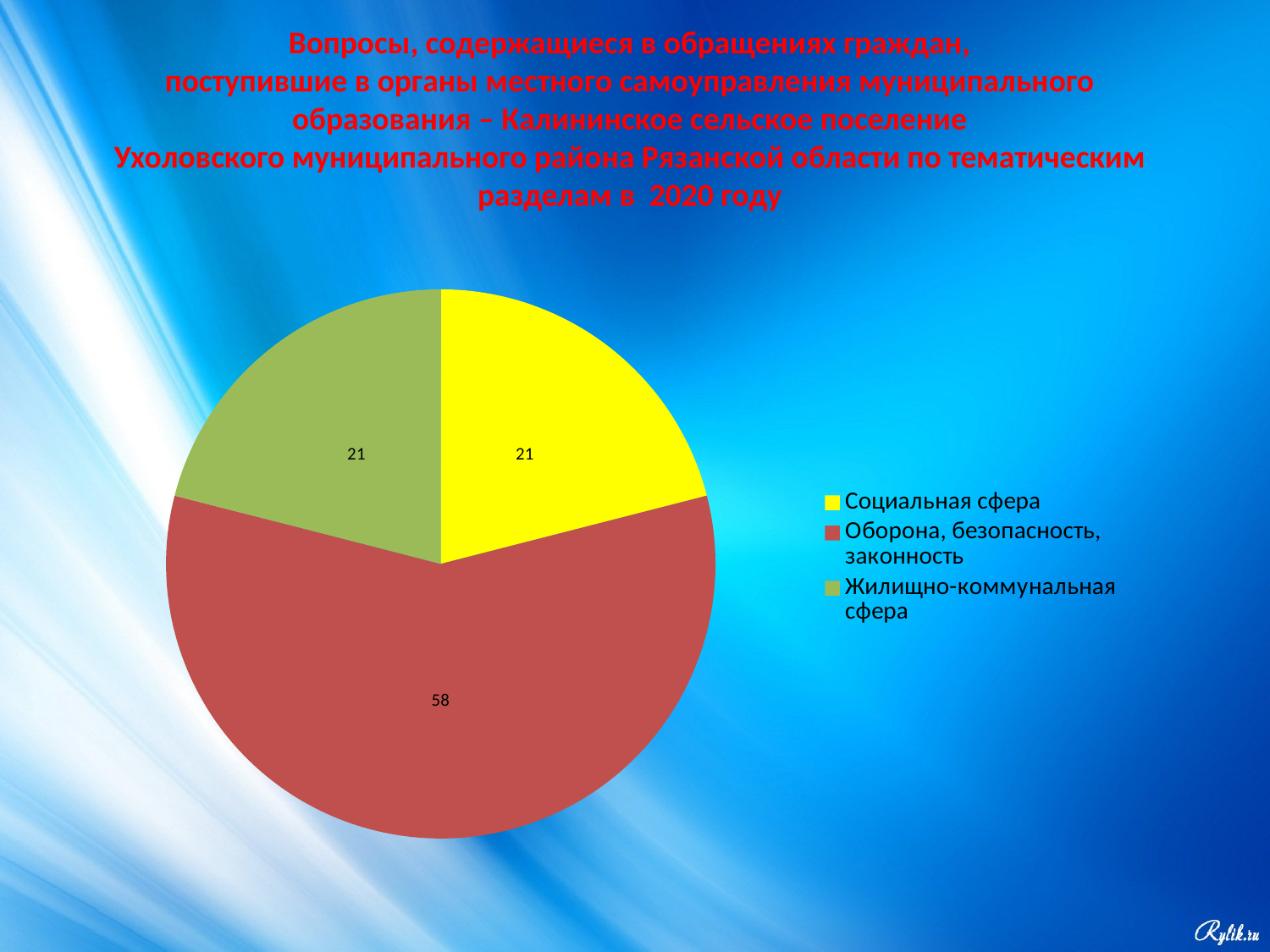
What value is shown for the slice "Социальная сфера"? 21 How many slices does the pie chart have? 3 How many entries does the legend list? 3 What share of the pie does "Оборона, безопасность, законность" represent? 58% What value is shown for the slice "Оборона, безопасность, законность"? 58 What is the difference between the values for "Оборона, безопасность, законность" and "Социальная сфера"? 37 What is the total of all the slice values in the pie chart? 100 What value is shown for the slice "Жилищно-коммунальная сфера"? 21 Which category has the largest slice of the pie? Оборона, безопасность, законность Which is larger: the value for "Оборона, безопасность, законность" or the value for "Жилищно-коммунальная сфера"? Оборона, безопасность, законность What colour is the slice for "Социальная сфера"? yellow What kind of chart is shown on the slide? pie chart